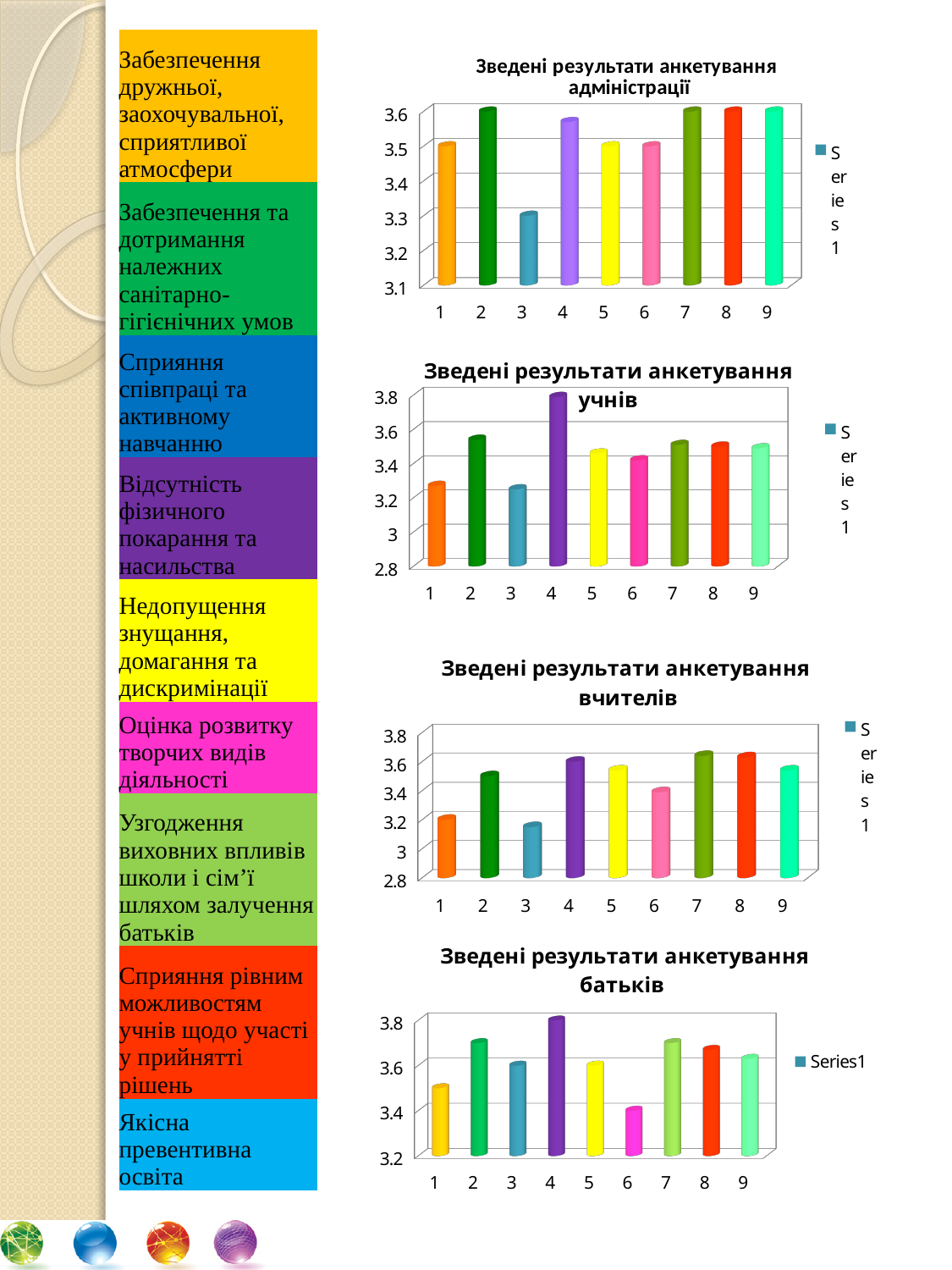
How many series does the legend of the 'Зведені результати анкетування батьків' chart list? 1 In the 'Зведені результати анкетування батьків' chart, which category has the highest value? 4 What is the legend entry shown on the 'Зведені результати анкетування батьків' chart? Series1 In the 'Зведені результати анкетування учнів' chart, is the value for category 1 greater or less than 3.4? less In the 'Зведені результати анкетування учнів' chart, which category has the highest value? 4 In the 'Зведені результати анкетування вчителів' chart, is the value for category 7 greater or less than 3.6? greater In the 'Зведені результати анкетування адміністрації' chart, which category has the lowest value? 3 What kind of chart is the 'Зведені результати анкетування батьків' chart? bar chart How many categories are shown on the x axis of the 'Зведені результати анкетування адміністрації' chart? 9 In the 'Зведені результати анкетування батьків' chart, which category has the lowest value? 6 In the 'Зведені результати анкетування адміністрації' chart, is the value for category 3 greater or less than 3.4? less In the 'Зведені результати анкетування вчителів' chart, which is larger, the value for category 4 or the value for category 1? category 4